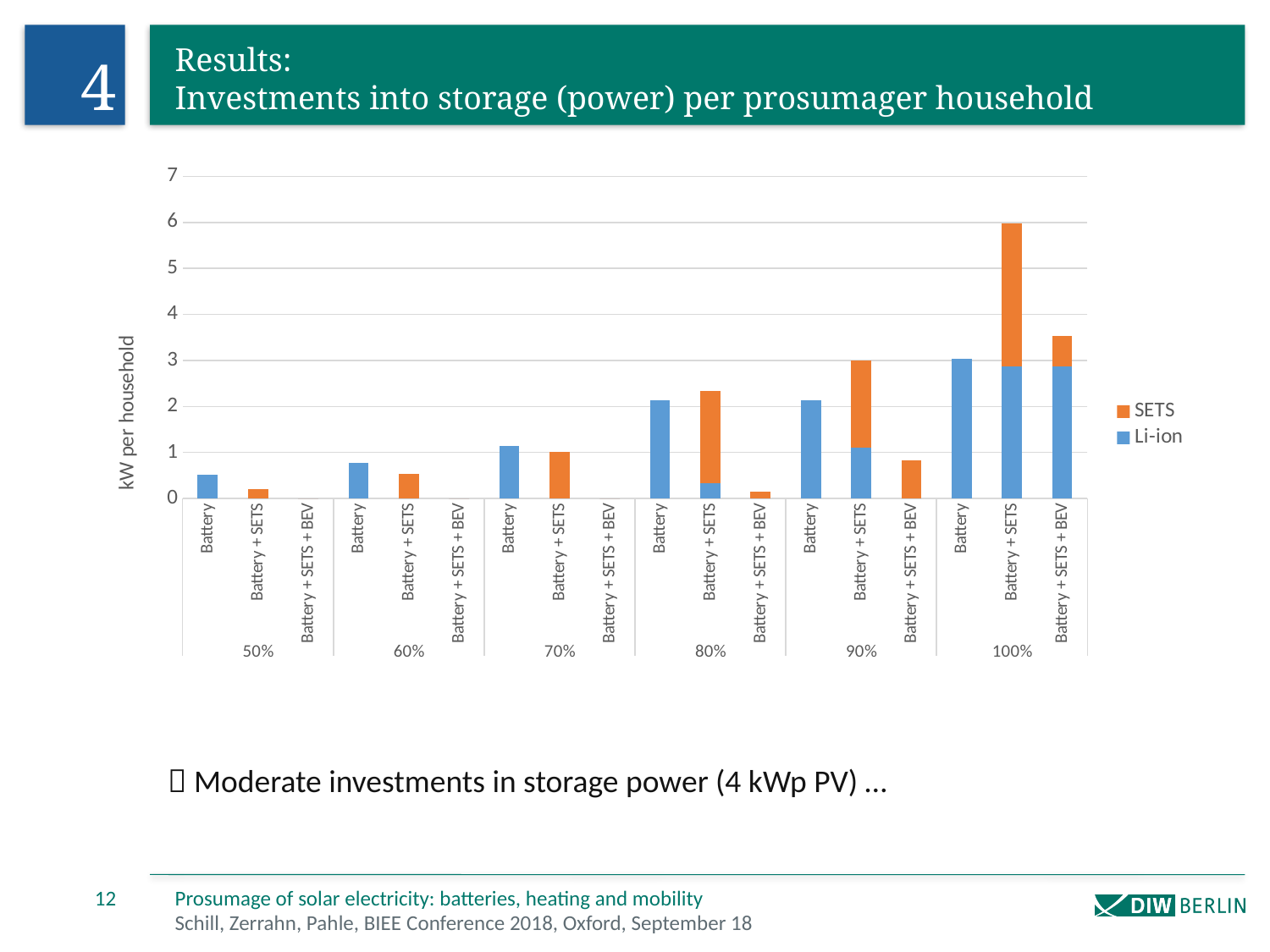
How many series does the legend list? 2 Which bar is the tallest in the chart? Battery + SETS at 100% How many percentage groups (50% to 100%) are shown along the x axis? 6 Is the total value for Battery + SETS at 100% greater or less than 5? greater What is the label of the vertical axis? kW per household Is the total value for Battery + SETS at 90% greater or less than 2? greater Which two series are listed in the chart legend? SETS and Li-ion What kind of chart is shown on the slide? Stacked bar chart Is the total value for Battery + SETS + BEV at 100% greater or less than 3? greater At 100%, which is larger: the total for Battery + SETS or the total for Battery + SETS + BEV? Battery + SETS Do the Battery bars rise or fall as the percentage increases from 50% to 100%? rise